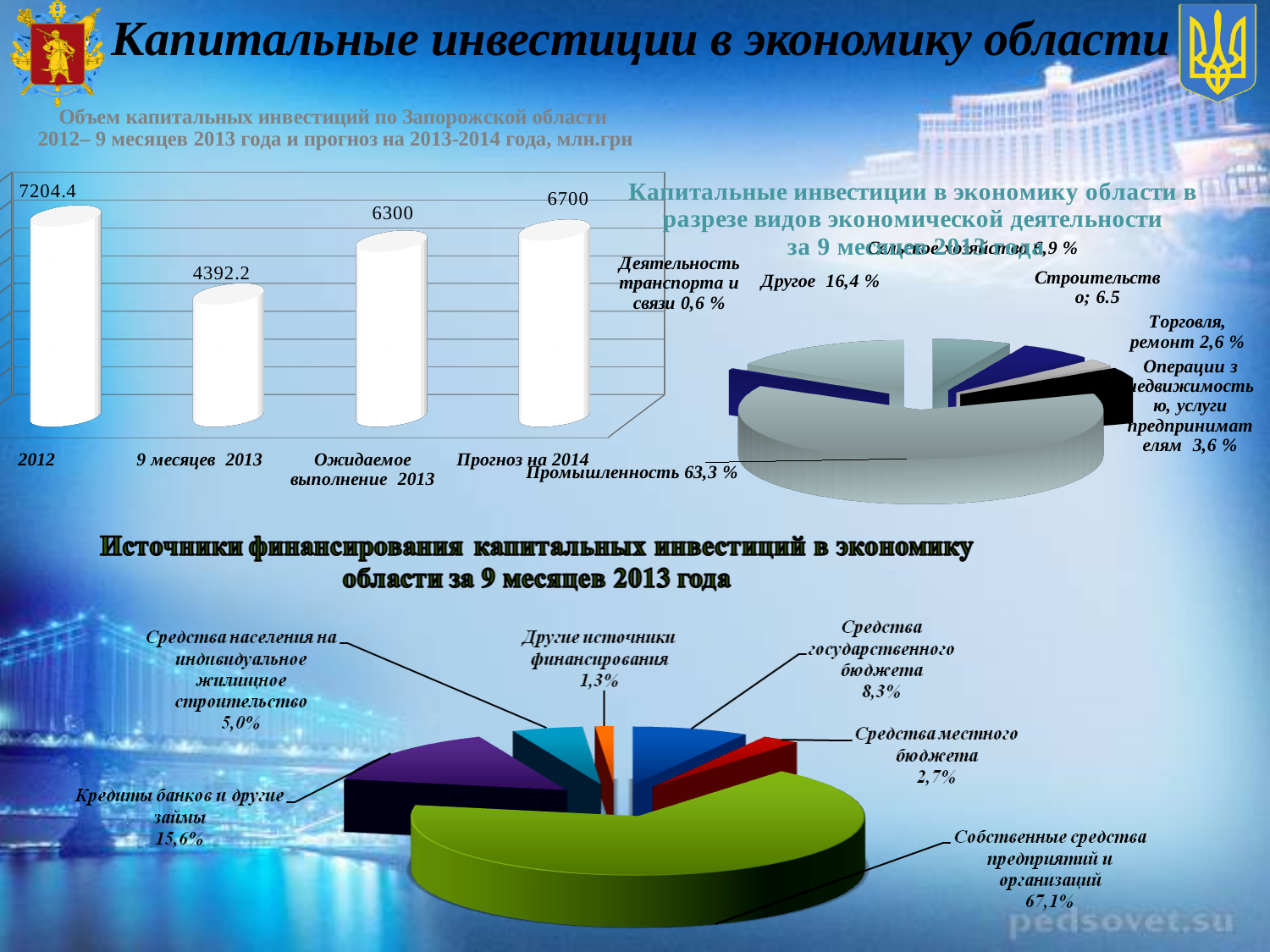
On the top-left bar chart of capital investment volume, what is the value for Прогноз на 2014? 6700 On the top-left bar chart of capital investment volume, what is the difference between Прогноз на 2014 and Ожидаемое выполнение 2013? 400 On the bottom pie chart of sources of financing, which source has the smallest share? Другие источники финансирования On the bottom pie chart of sources of financing, what share do Собственные средства предприятий и организаций have? 67,1% On the top-left bar chart of capital investment volume, what is the value for 9 месяцев 2013? 4392.2 On the bottom pie chart of sources of financing, which is larger: Кредиты банков и другие займы or Средства государственного бюджета? Кредиты банков и другие займы On the top-left bar chart of capital investment volume, how many bars are shown? 4 What type of chart is the top-left chart of capital investment volume? Bar chart On the top-right pie chart of investments by type of economic activity, what share does Промышленность have? 63,3 % On the top-left bar chart of capital investment volume, what is the value for 2012? 7204.4 On the top-left bar chart of capital investment volume, which category has the lowest value? 9 месяцев 2013 On the top-right pie chart of investments by type of economic activity, what share does Другое have? 16,4 %